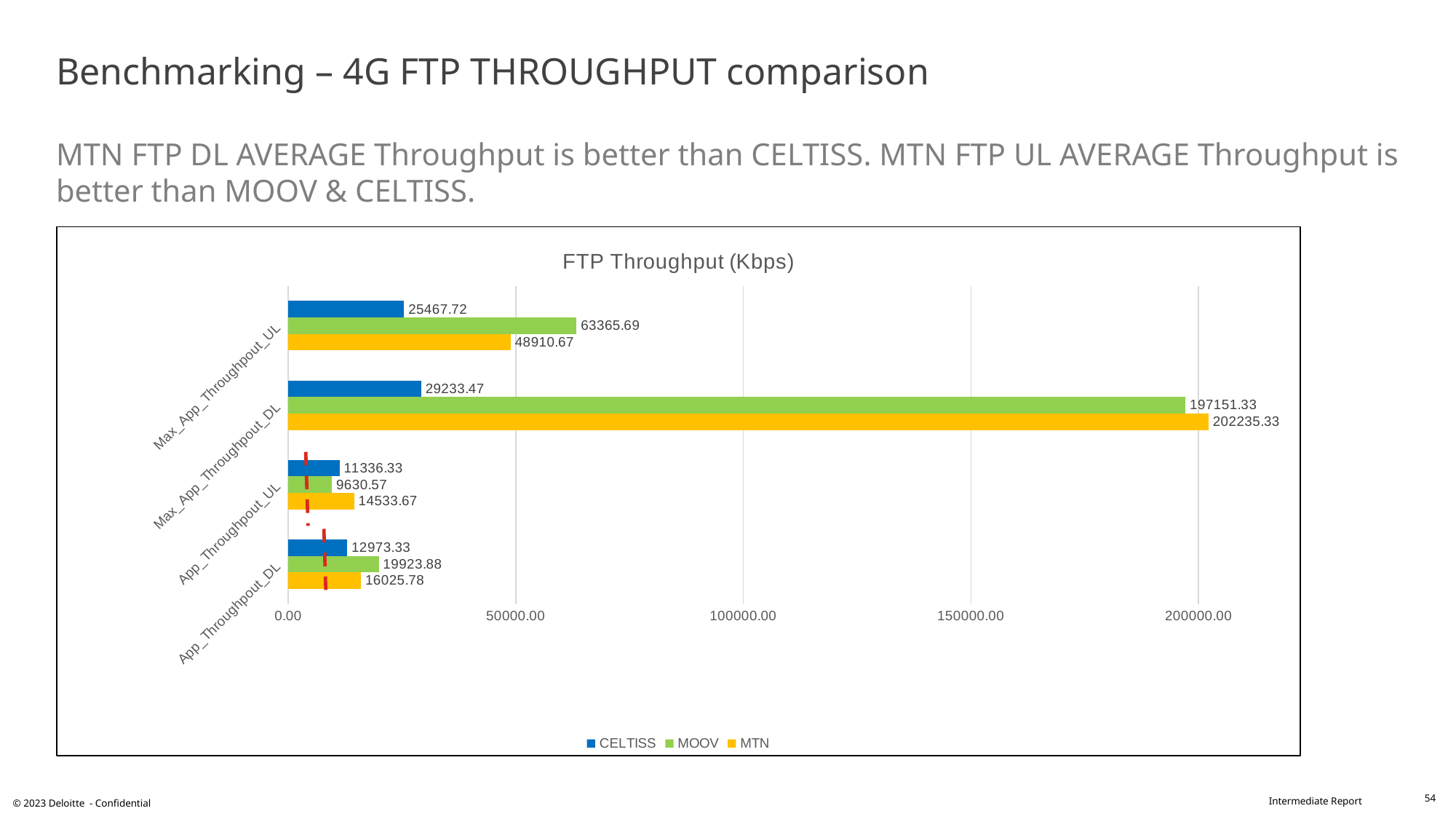
Is the MOOV value for Max_App_Throughpout_DL greater or less than 150000.00? greater What type of chart is shown on the slide? Bar chart What is the CELTISS value for App_Throughpout_UL? 11336.33 Which series has the highest value for App_Throughpout_DL? MOOV Which is larger for Max_App_Throughpout_UL: the MTN value or the CELTISS value? MTN Which series has the lowest value for Max_App_Throughpout_DL? CELTISS How many series does the legend list? 3 What is the MOOV value for Max_App_Throughpout_UL? 63365.69 What is the MTN value for Max_App_Throughpout_DL? 202235.33 What is the title of the chart? FTP Throughput (Kbps) What is the difference between the MTN and CELTISS values for App_Throughpout_UL? 3197.34 How many categories are shown on the vertical axis of the chart? 4